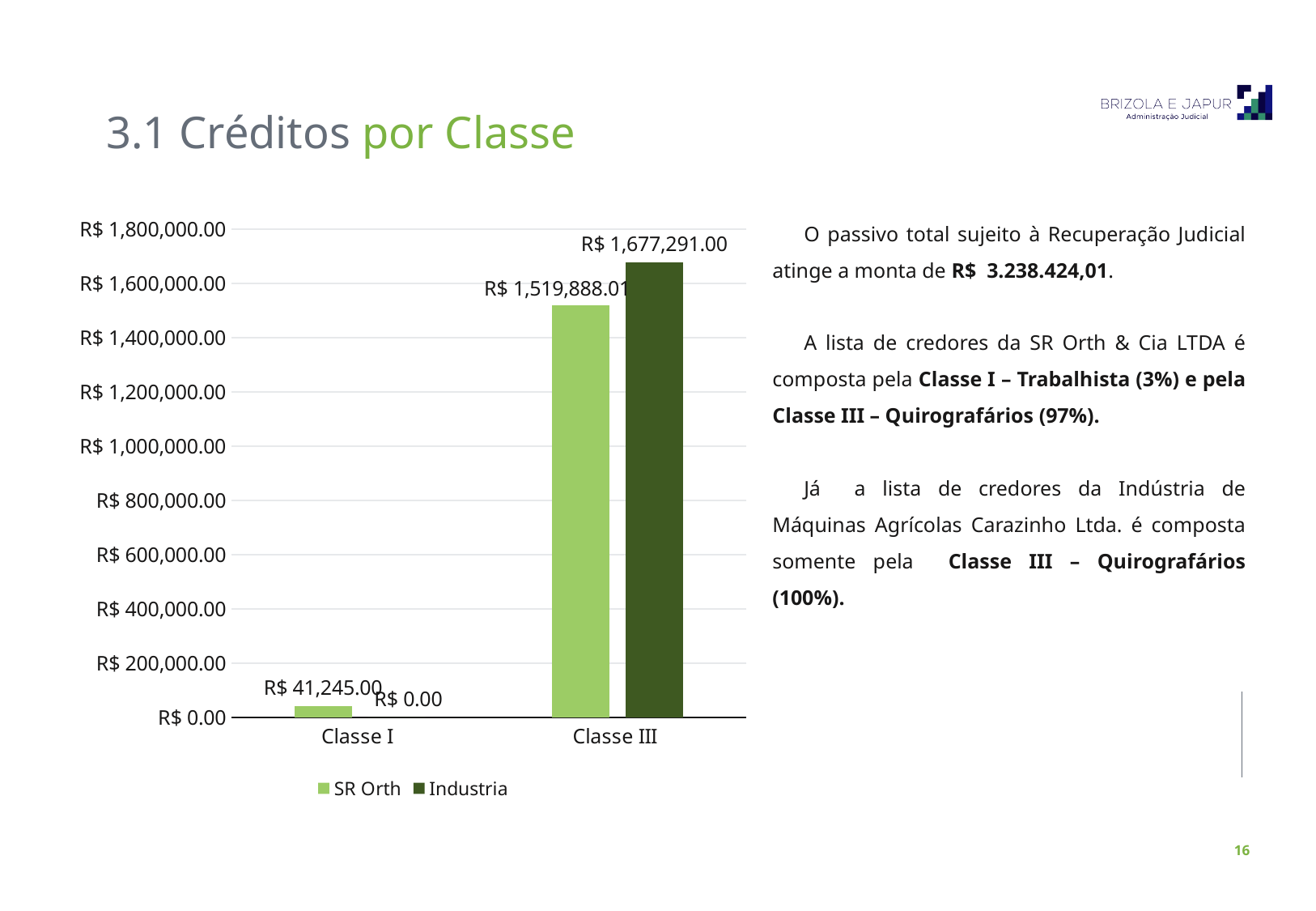
Which bar has the lowest value in the chart? Industria in Classe I Is the value for SR Orth in Classe III greater or less than R$ 1,400,000.00? greater Which series has the highest value in Classe III? Industria What is the value for Industria in Classe III? R$ 1,677,291.00 What kind of chart is shown on the slide? Bar chart What is the value for SR Orth in Classe III? R$ 1,519,888.01 How many series does the legend list? 2 How many categories are shown on the x axis? 2 What is the difference between the Industria and SR Orth values in Classe III? R$ 157,402.99 What is the value for Industria in Classe I? R$ 0.00 What is the value for SR Orth in Classe I? R$ 41,245.00 Which is larger in Classe I, SR Orth or Industria? SR Orth